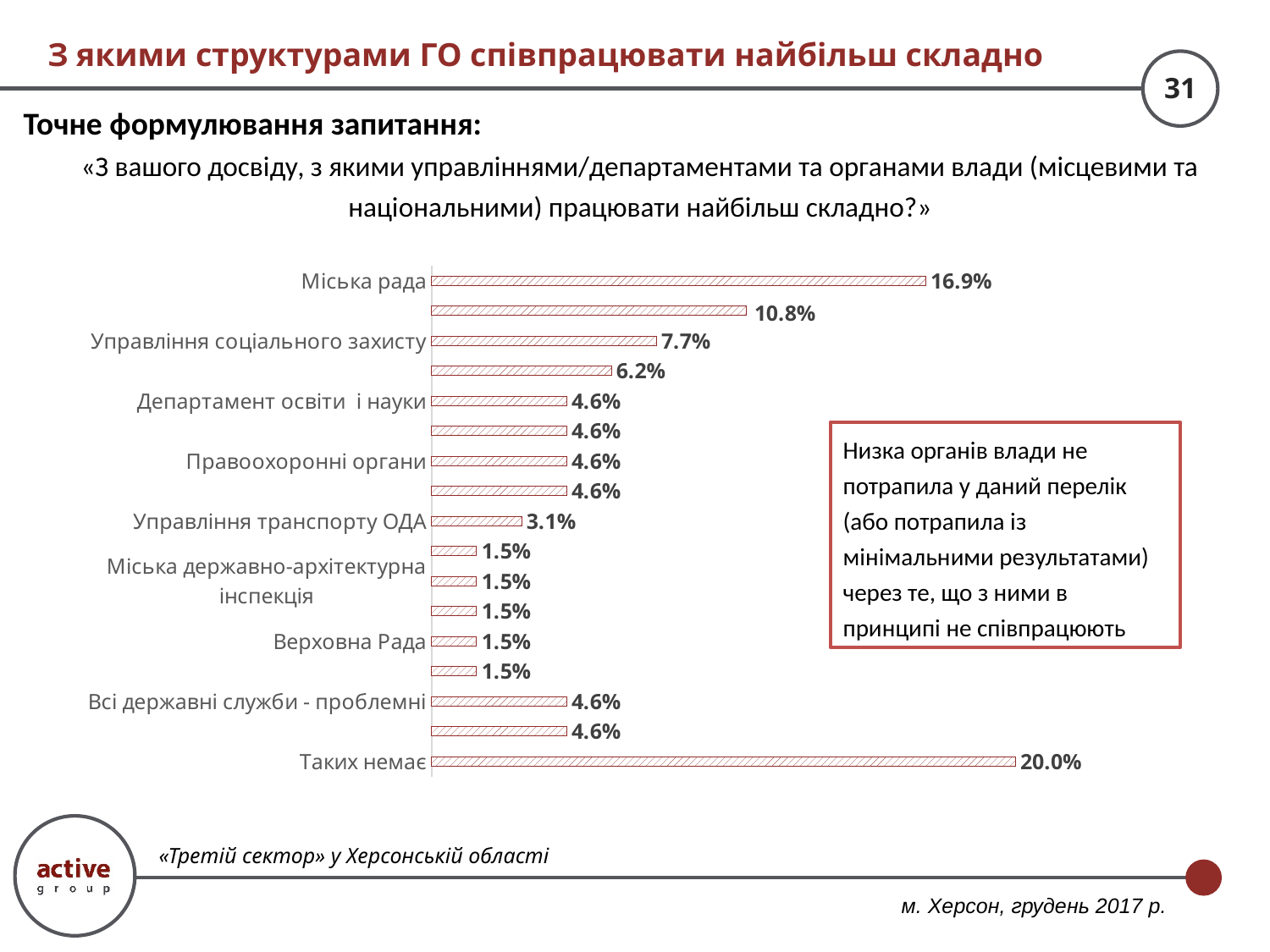
What is the value for Міська рада? 16.9% Which category has the highest value? Таких немає What is the value for Верховна Рада? 1.5% What type of chart is shown on the slide? bar chart What is the value for Правоохоронні органи? 4.6% Which is larger: the value for Міська рада or the value for Управління соціального захисту? Міська рада What is the value for Таких немає? 20.0% What is the difference between the values for Таких немає and Міська рада? 3.1% What is the value for Управління транспорту ОДА? 3.1% How many bars are plotted on the chart? 17 What is the value for Управління соціального захисту? 7.7% What is the lowest value shown on the chart? 1.5%